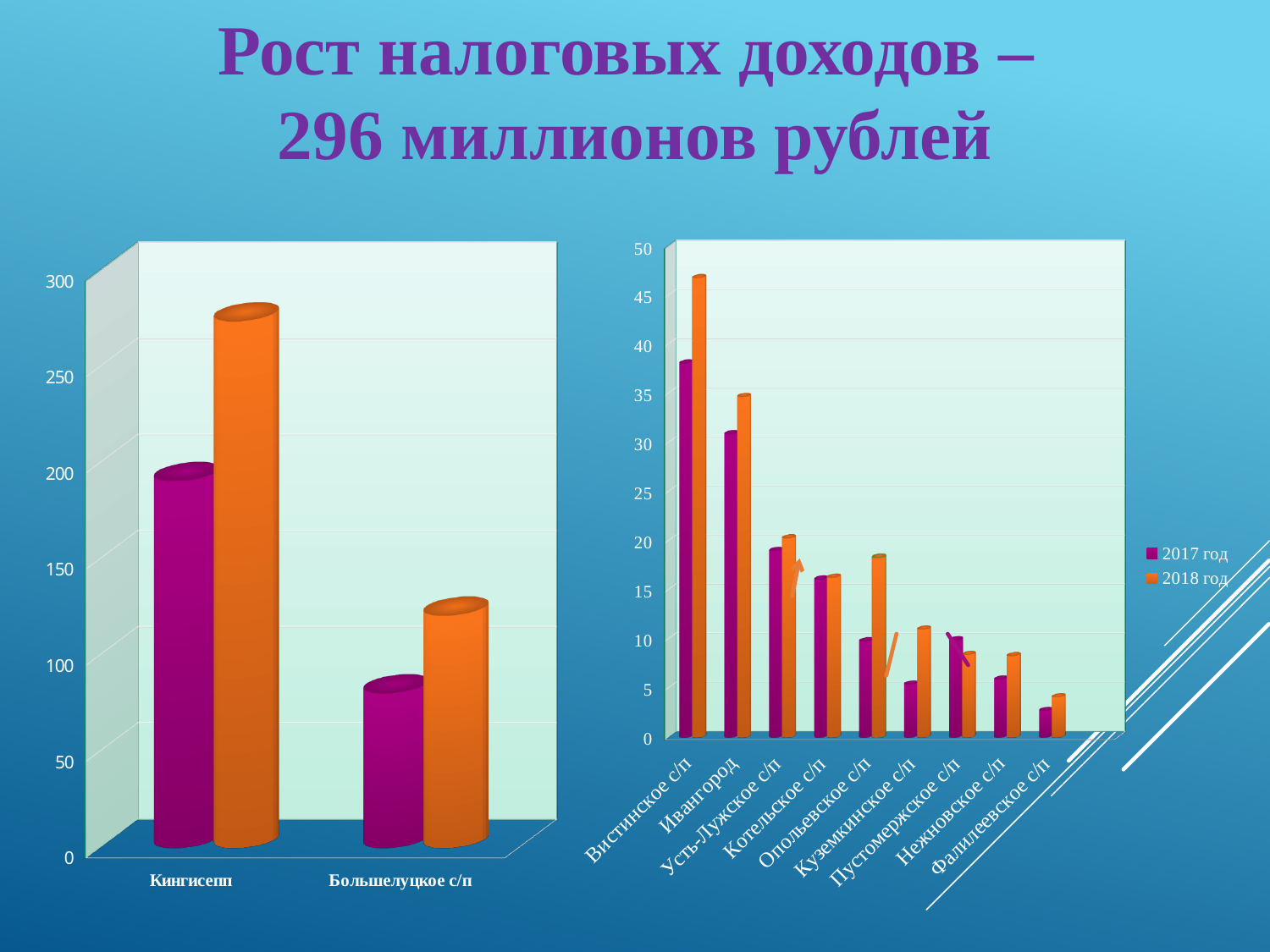
In the right chart, which category has the lowest 2017 год value? Фалилеевское с/п In the left chart, is the purple (2017 год) value for Большелуцкое с/п greater or less than 100? less How many categories does the left chart show? 2 How many charts are on the slide? 2 In the right chart, which category has the highest 2018 год value? Вистинское с/п In the left chart, which category has the highest value? Кингисепп What kind of chart is the left chart? bar chart How many series does the legend of the right chart list? 2 In the right chart, which is larger for Опольевское с/п: the 2017 год value or the 2018 год value? 2018 год How many categories does the right chart show? 9 In the right chart, is the 2018 год value for Вистинское с/п greater or less than 45? greater In the left chart, is the orange (2018 год) value for Кингисепп greater or less than 250? greater